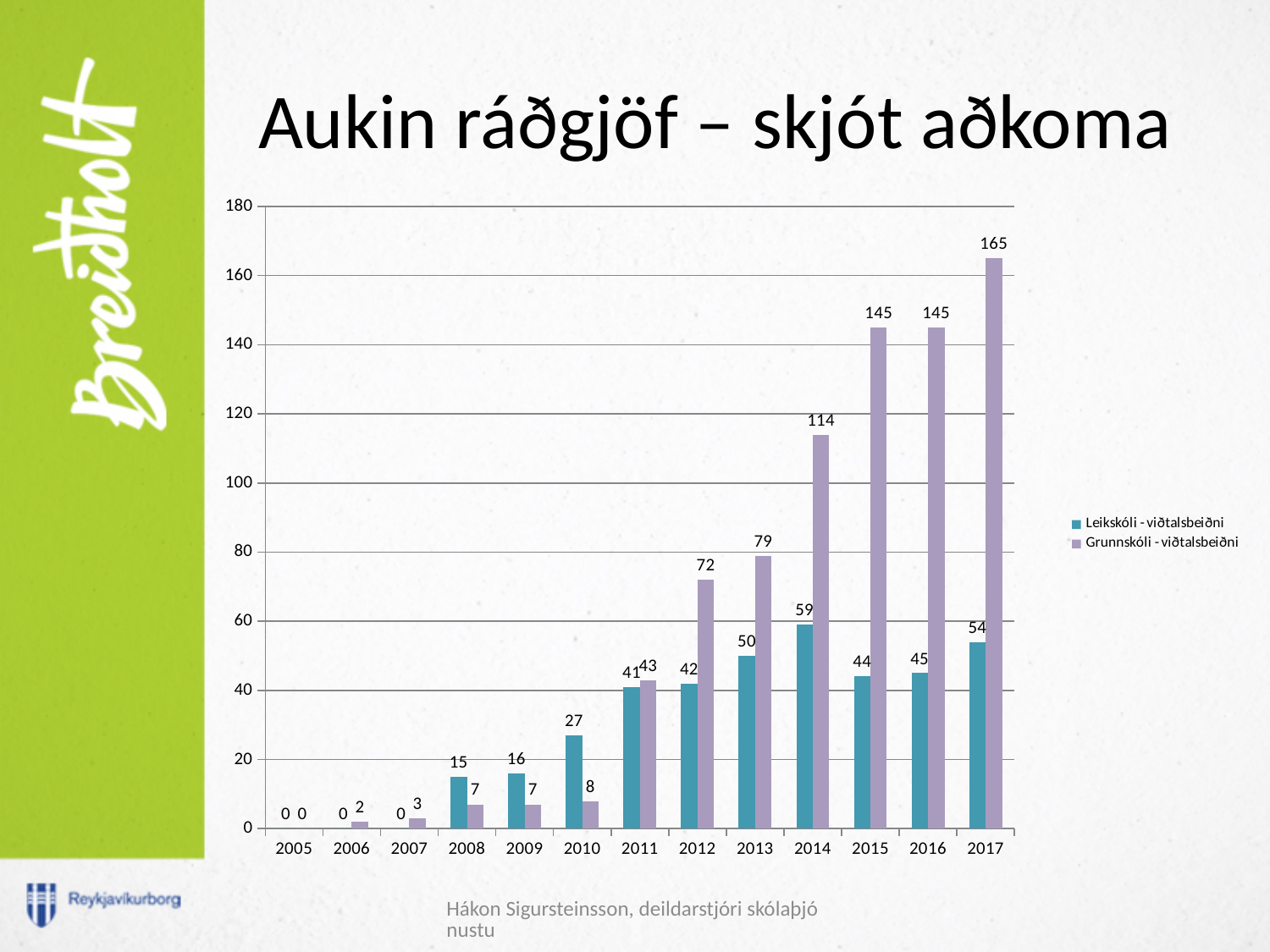
In which year is the Leikskóli - viðtalsbeiðni value highest? 2014 In which year is the Grunnskóli - viðtalsbeiðni value highest? 2017 Do the Grunnskóli - viðtalsbeiðni values generally rise or fall from 2005 to 2017? Rise What is the value for Grunnskóli - viðtalsbeiðni in 2017? 165 What is the value for Leikskóli - viðtalsbeiðni in 2014? 59 Which is larger in 2011: Leikskóli - viðtalsbeiðni or Grunnskóli - viðtalsbeiðni? Grunnskóli - viðtalsbeiðni What kind of chart is shown on the slide? Bar chart What is the difference between the Grunnskóli - viðtalsbeiðni values for 2017 and 2016? 20 How many series does the legend list? 2 What is the value for Grunnskóli - viðtalsbeiðni in 2012? 72 How many years are shown on the x axis? 13 What is the difference between the Grunnskóli and Leikskóli viðtalsbeiðni values in 2014? 55